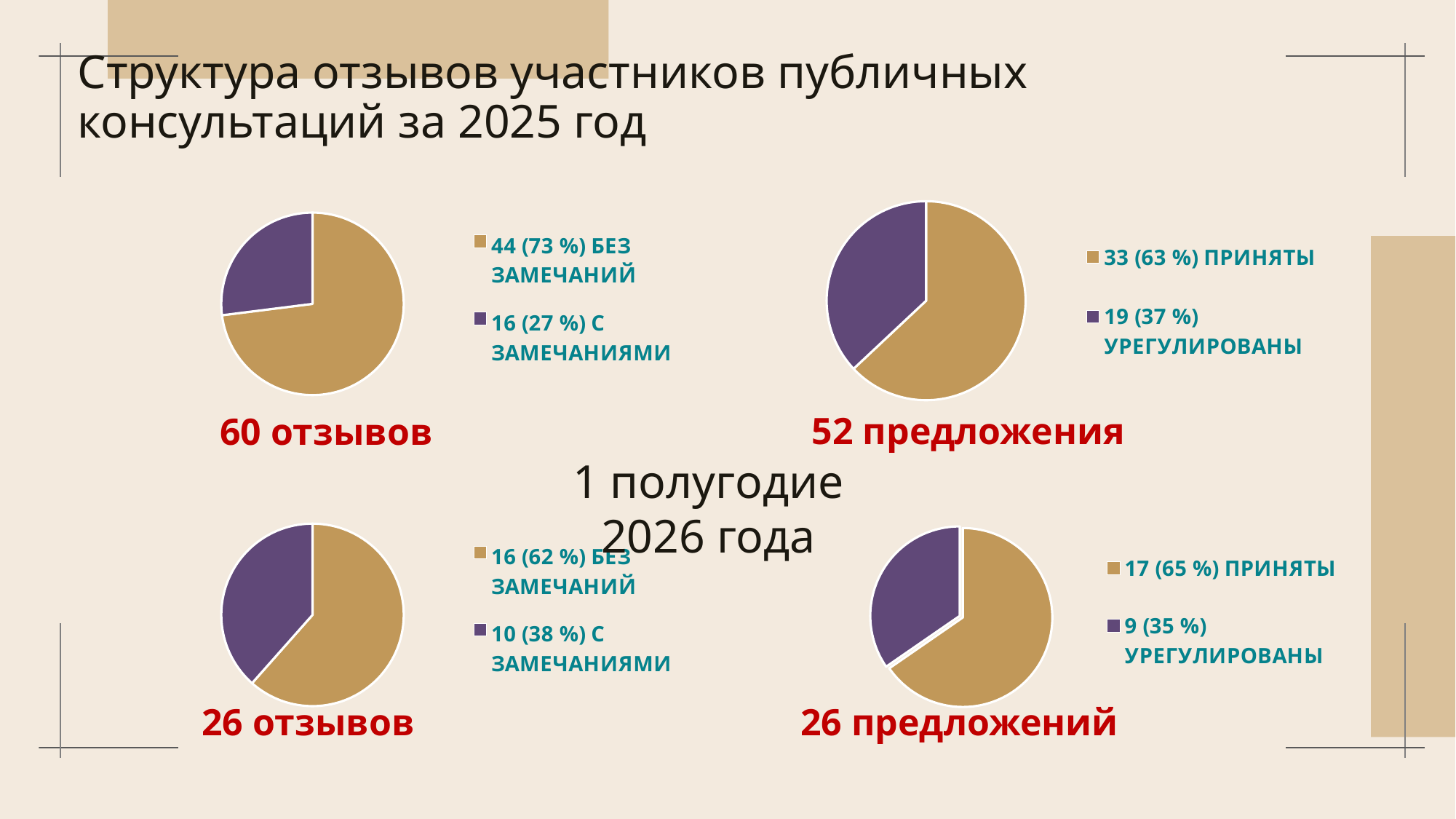
In the bottom-left pie chart ("26 отзывов"), which slice is larger: "БЕЗ ЗАМЕЧАНИЙ" or "С ЗАМЕЧАНИЯМИ"? БЕЗ ЗАМЕЧАНИЙ How many entries does the legend of the bottom-left pie chart ("26 отзывов") list? 2 In the top-right pie chart ("52 предложения"), how many proposals are "ПРИНЯТЫ"? 33 (63 %) In the bottom-left pie chart ("26 отзывов"), how many reviews are "С ЗАМЕЧАНИЯМИ"? 10 (38 %) In the bottom-right pie chart ("26 предложений"), how many proposals are "УРЕГУЛИРОВАНЫ"? 9 (35 %) In the top-left pie chart ("60 отзывов"), how many reviews are "БЕЗ ЗАМЕЧАНИЙ"? 44 (73 %) In the top-right pie chart ("52 предложения"), what is the difference between the number of "ПРИНЯТЫ" and "УРЕГУЛИРОВАНЫ" proposals? 14 How many slices does the top-right pie chart ("52 предложения") have? 2 In the top-left pie chart ("60 отзывов"), what colour is the "С ЗАМЕЧАНИЯМИ" slice? Purple In the bottom-right pie chart ("26 предложений"), which slice is the largest? ПРИНЯТЫ In the top-left pie chart ("60 отзывов"), what share of the pie is "С ЗАМЕЧАНИЯМИ"? 27 % What kind of chart is the top-left chart labelled "60 отзывов"? Pie chart